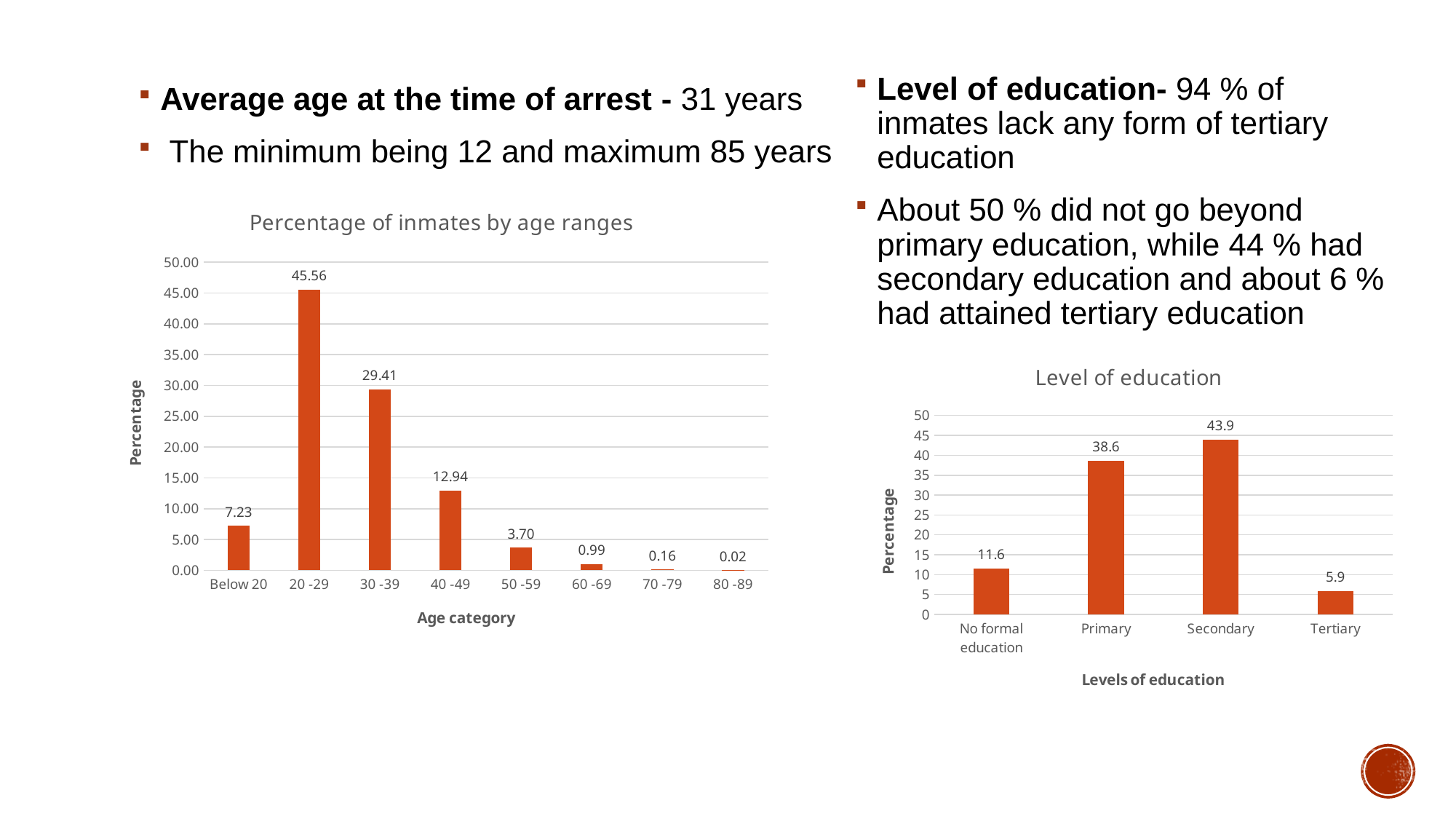
In the 'Level of education' chart, which level of education has the lowest percentage? Tertiary In the 'Percentage of inmates by age ranges' chart, what is the value for the 60 -69 age category? 0.99 In the 'Percentage of inmates by age ranges' chart, which age category has the highest percentage? 20 -29 In the 'Level of education' chart, what is the difference between the values for Secondary and No formal education? 32.3 In the 'Level of education' chart, which level of education has the highest percentage? Secondary In the 'Level of education' chart, what is the value for Primary? 38.6 What type of chart is the 'Level of education' chart? Bar chart In the 'Percentage of inmates by age ranges' chart, what is the value for the 20 -29 age category? 45.56 In the 'Percentage of inmates by age ranges' chart, which age category has the lowest percentage? 80 -89 In the 'Percentage of inmates by age ranges' chart, what is the difference between the values for 30 -39 and 40 -49? 16.47 In the 'Level of education' chart, which is larger, the value for Primary or the value for Tertiary? Primary In the 'Percentage of inmates by age ranges' chart, how many age categories are shown? 8